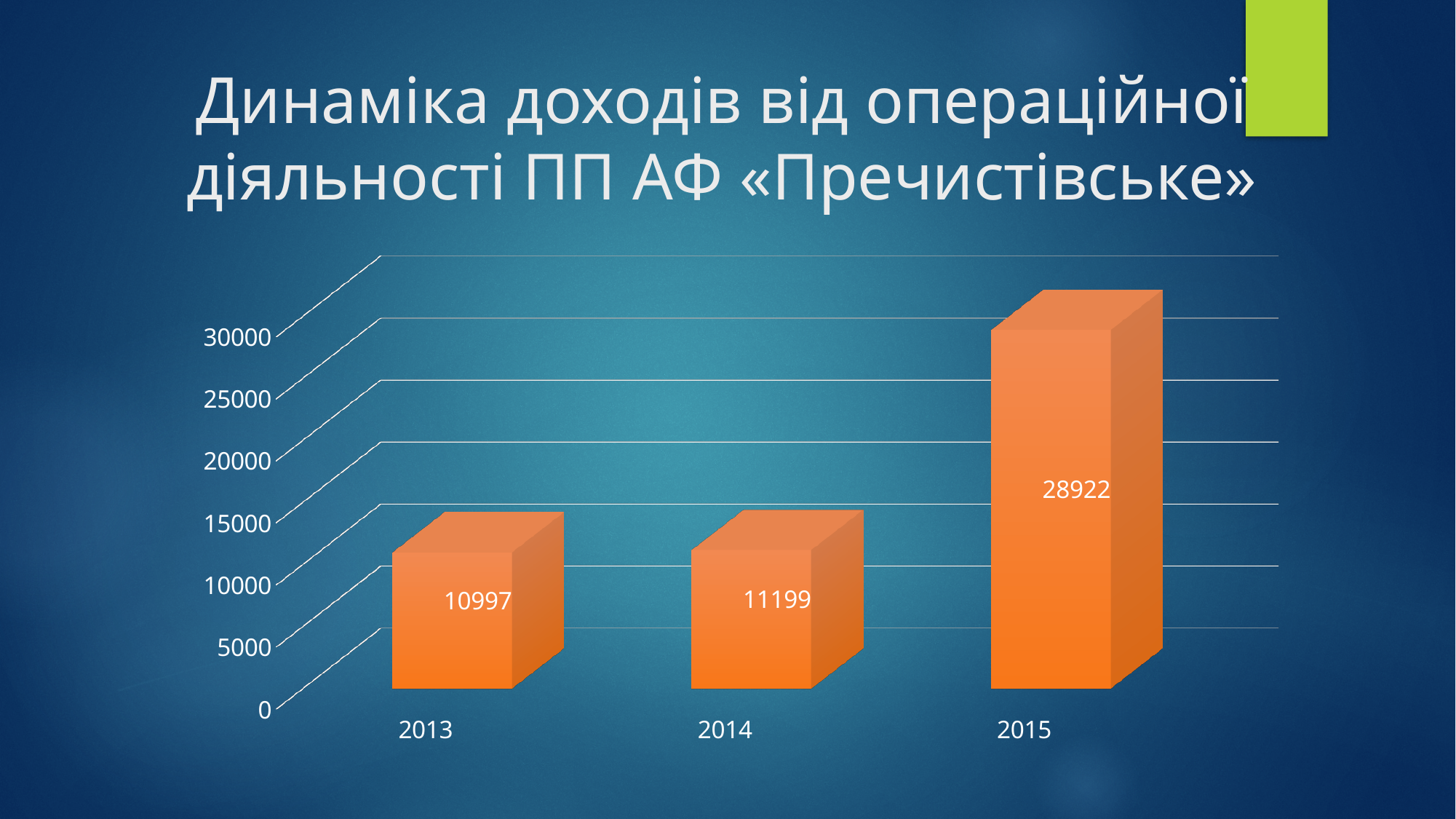
What is the value for 2013? 10997 Which is larger, the value for 2015 or the value for 2013? 2015 What is the difference between the values for 2015 and 2014? 17723 What is the value for 2014? 11199 What is the difference between the values for 2014 and 2013? 202 Is the value for 2015 greater or less than 25000? greater Do the values rise or fall from 2013 to 2015? rise What kind of chart is shown on the slide? bar chart What is the value for 2015? 28922 How many years are shown on the x axis? 3 Which year has the lowest value? 2013 Which year has the highest value? 2015